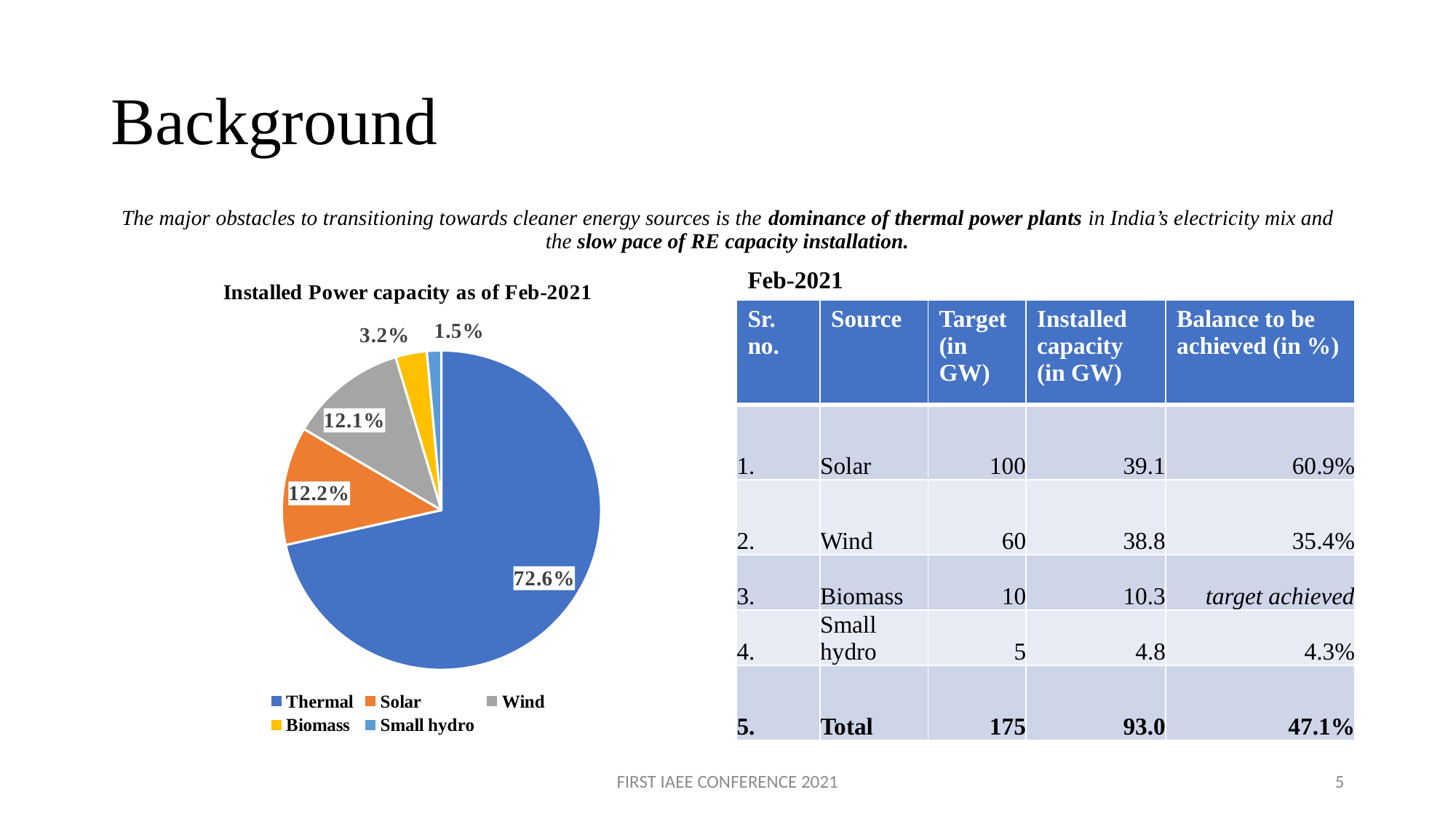
What kind of chart is shown on the slide? pie chart What is the difference in percentage points between the Thermal and Solar slices? 60.4% What share of installed power capacity does Small hydro have in the pie chart? 1.5% How many sources are shown in the pie chart? 5 What share of installed power capacity does Thermal have in the pie chart? 72.6% What is the title of the chart? Installed Power capacity as of Feb-2021 What share of installed power capacity does Solar have in the pie chart? 12.2% Which slice is larger, Biomass or Small hydro? Biomass Which source has the smallest slice in the pie chart? Small hydro Which source has the largest slice in the pie chart? Thermal